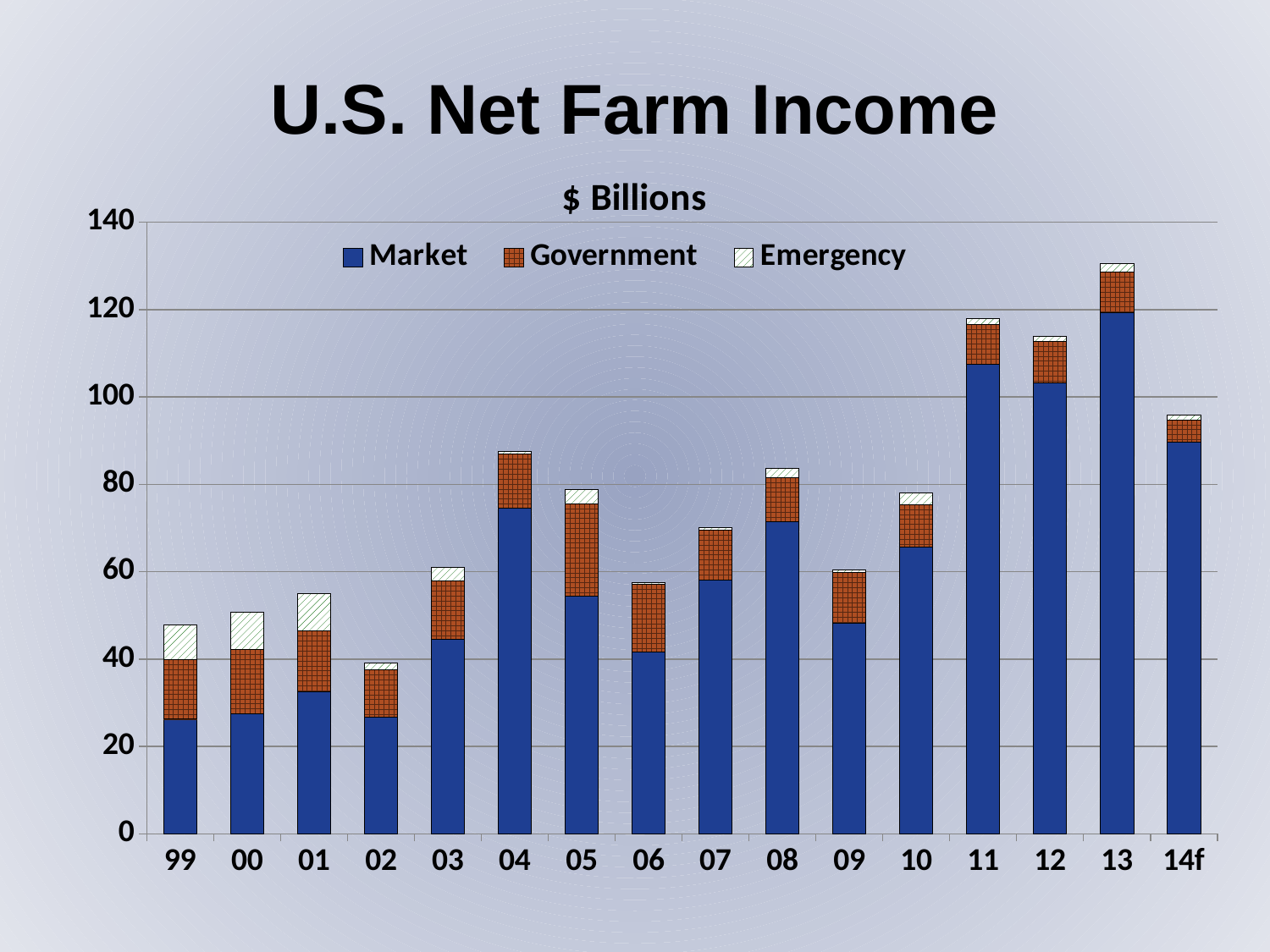
Is the Market segment for 11 greater or less than 100? greater Which year has the larger total bar, 08 or 09? 08 Is the total bar for 13 greater or less than 120? greater How many years (categories) are shown on the x axis? 16 Which year has the lowest total net farm income bar? 02 Do the total bars rise or fall from 10 to 13? rise Which year has the larger Market segment, 05 or 06? 05 What unit is given in the chart's subtitle? $ Billions Which year has the highest total net farm income bar? 13 Is the total bar for 99 greater or less than 60? less What kind of chart is shown on the slide? Stacked bar chart How many series does the legend list? 3